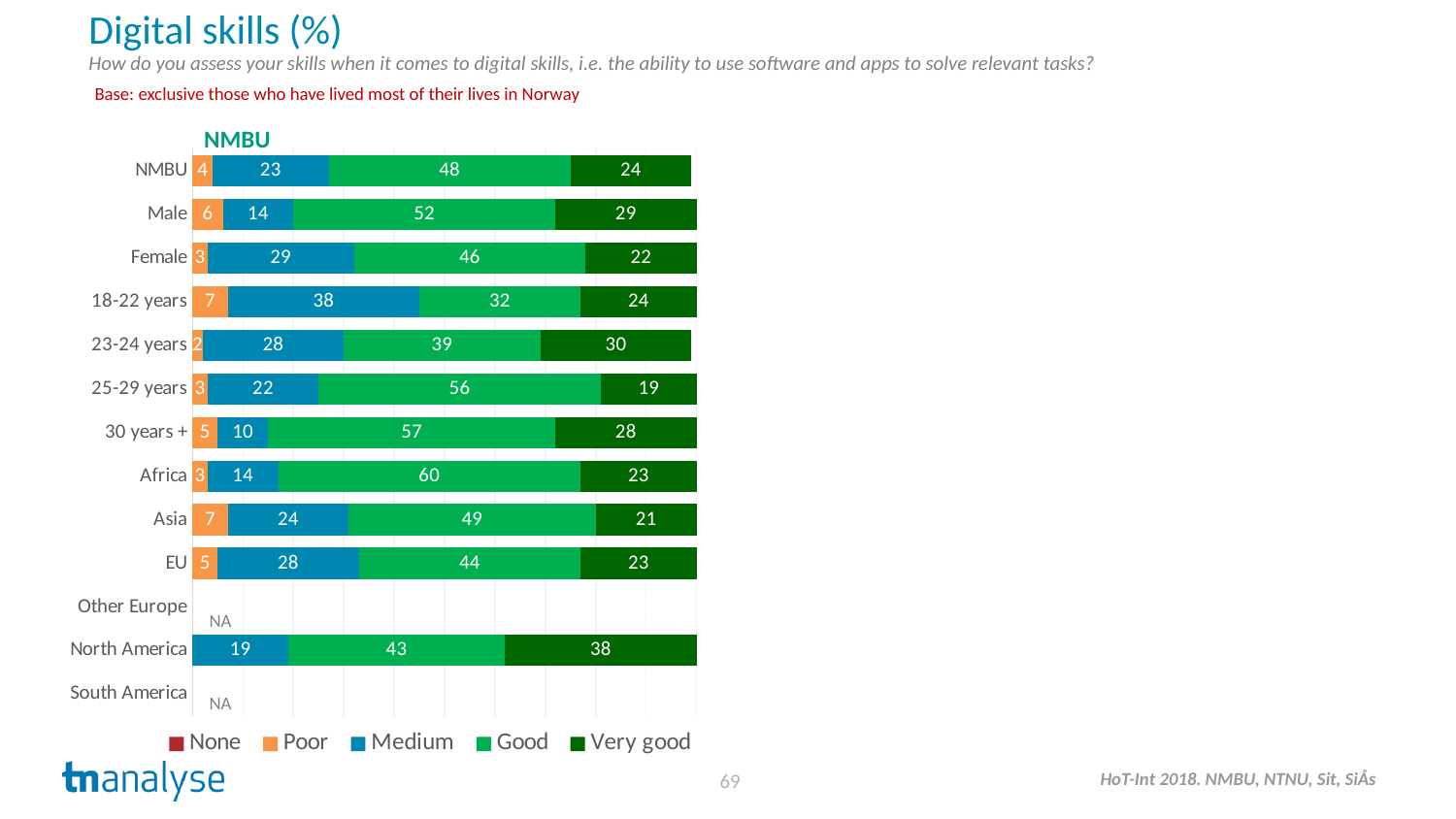
What is the Medium value for the 18-22 years group? 38 How many series does the legend list? 5 Which has a larger Medium value, Male or Female? Female Which category has the highest Very good value? North America What kind of chart is shown on the slide? Stacked bar chart Which category has the highest Good value? Africa What is the Poor value for Asia? 7 What is the value for Good for Africa? 60 Which category has the lowest Medium value among those with data? 30 years + What is the Very good value for North America? 38 What is the difference between the Very good values for Male and Female? 7 What is the total of the North America bar? 100